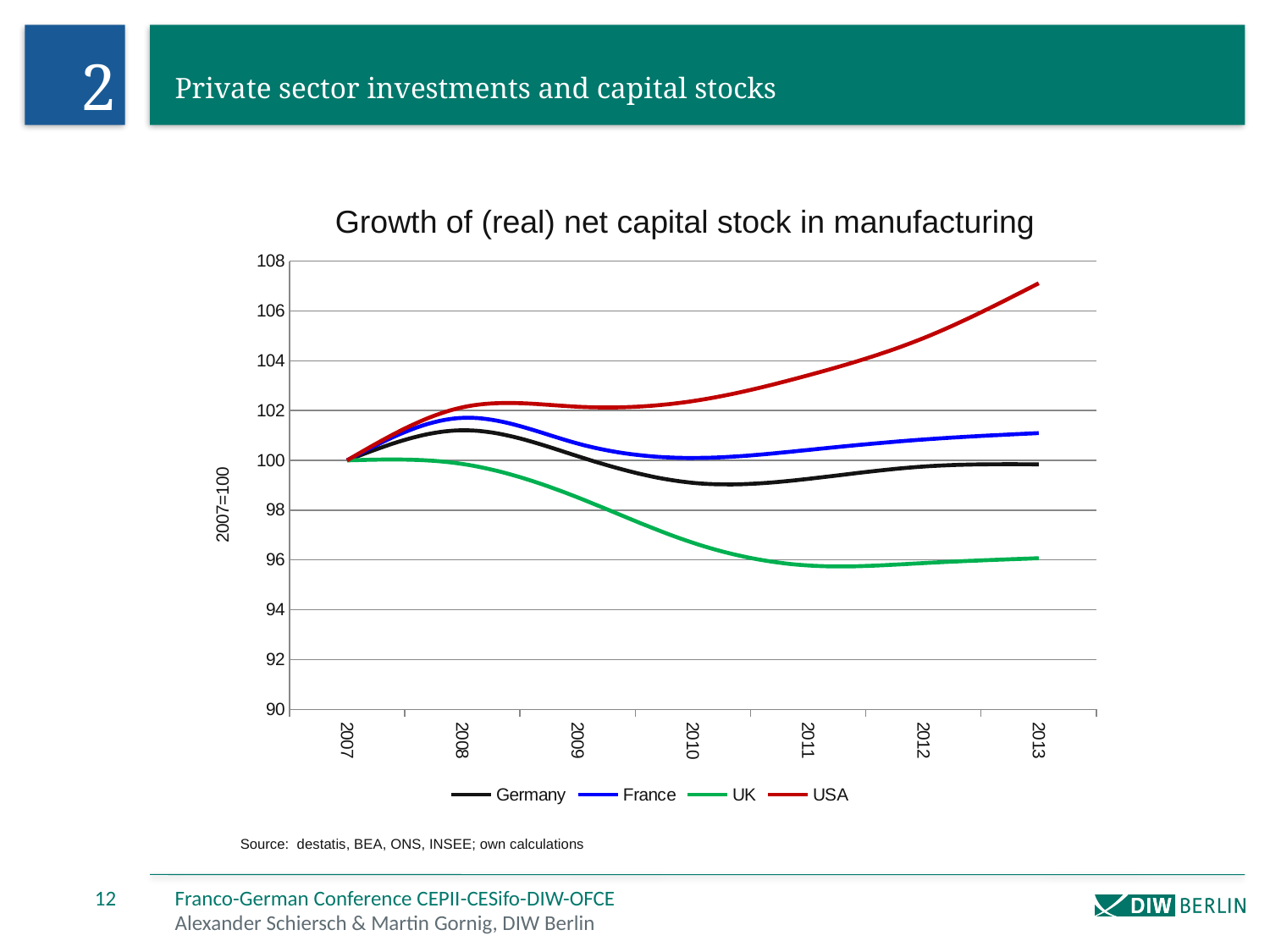
What kind of chart is shown on the slide? line chart Which country has the highest value in 2013? USA Does the USA line rise or fall from 2010 to 2013? rise Is the value for UK in 2013 greater or less than 98? less Which country has the lowest value in 2013? UK What is the title of the chart? Growth of (real) net capital stock in manufacturing How many series does the legend list? 4 Is the value for USA in 2013 greater or less than 106? greater How many years are labelled on the x axis? 7 Which is larger in 2013, the value for France or the value for Germany? France Is the value for Germany in 2010 greater or less than 100? less What is the value for Germany in 2007? 100